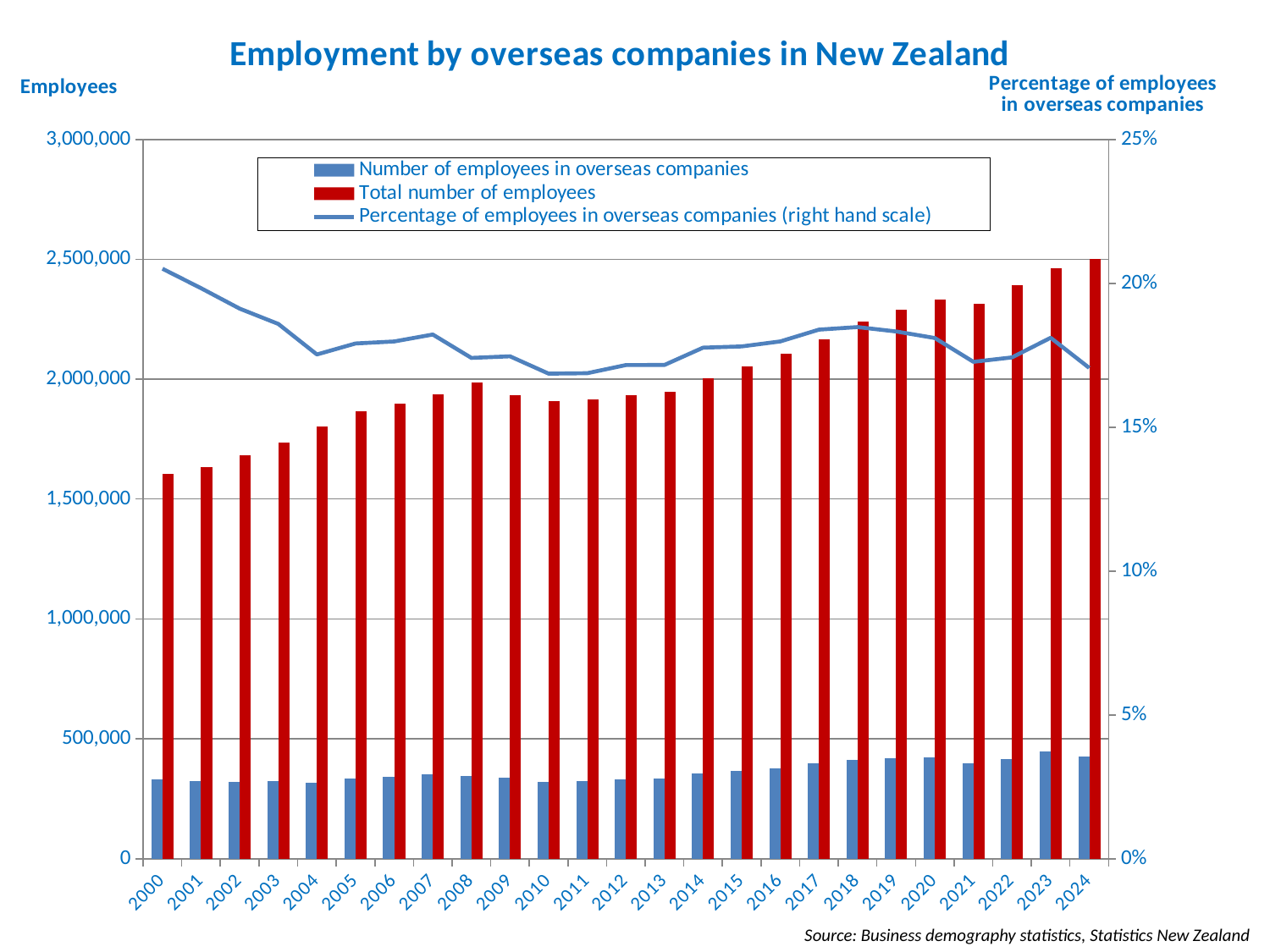
In which year is the Total number of employees lowest? 2000 What is the title of the chart? Employment by overseas companies in New Zealand What kind of chart is shown on the slide? A bar chart combined with a line In which year is the Percentage of employees in overseas companies highest? 2000 How many years are shown on the x axis? 25 Is the Total number of employees in 2000 greater or less than 2,000,000? less Is the Total number of employees in 2022 greater or less than 2,000,000? greater Is the Percentage of employees in overseas companies in 2024 greater or less than 20%? less In which year is the Total number of employees highest? 2024 How many series does the legend list? 3 Which is larger, the Total number of employees in 2009 or in 2010? 2009